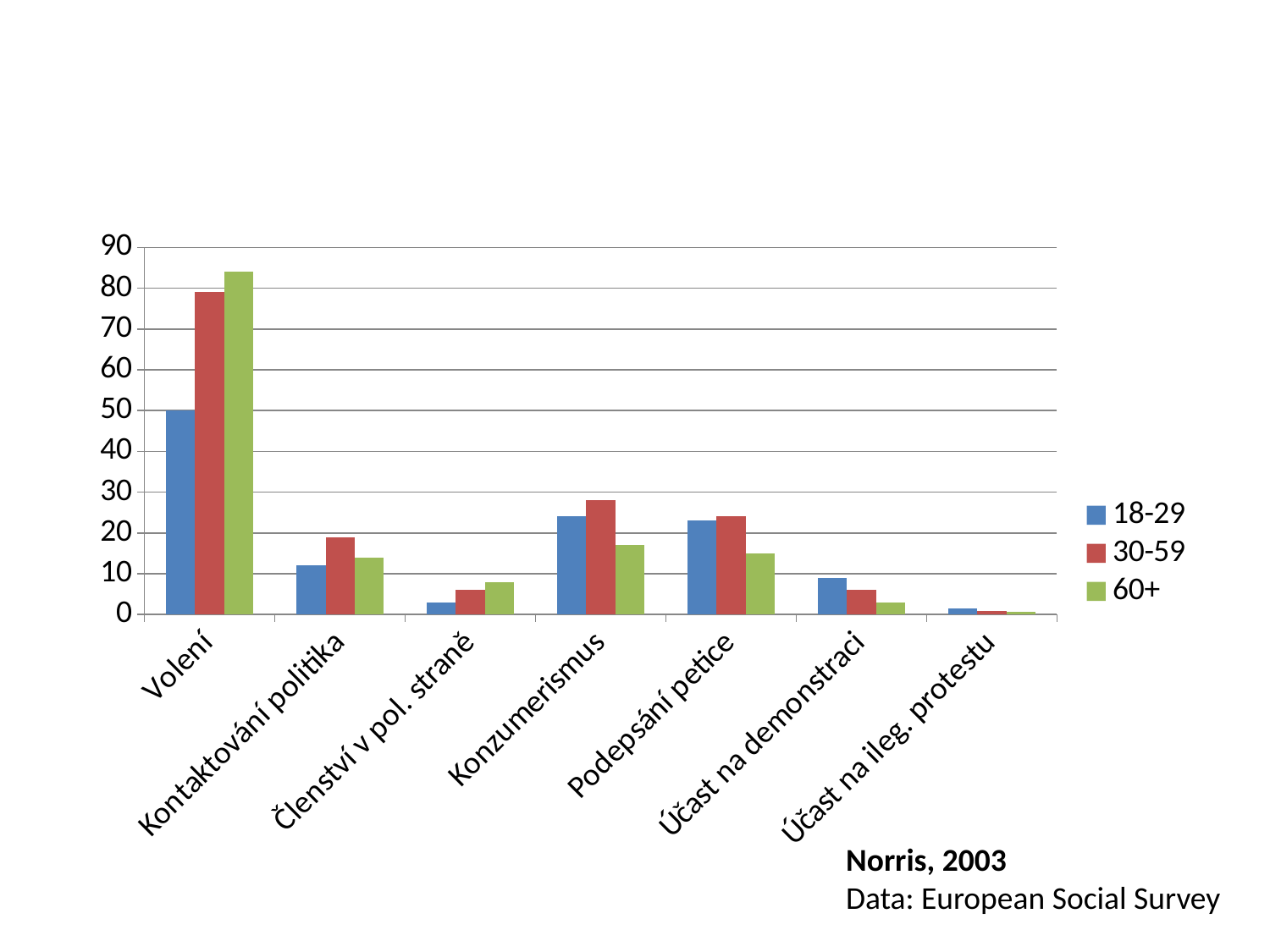
Which category has the highest value for the 60+ series? Volení Which age groups are listed in the chart's legend? 18-29, 30-59, 60+ Is the value for Volení in the 30-59 series greater or less than 70? greater For Účast na demonstraci, which series has the larger value: 18-29 or 60+? 18-29 How many categories are shown on the x axis of the chart? 7 What data source is cited below the chart? European Social Survey For Volení, which series has the larger value: 18-29 or 60+? 60+ Is the value for Konzumerismus in the 60+ series greater or less than 20? less Is the value for Kontaktování politika in the 18-29 series greater or less than 10? greater What kind of chart is shown on the slide? bar chart Which category has the lowest value for the 30-59 series? Účast na ileg. protestu How many series does the chart's legend list? 3